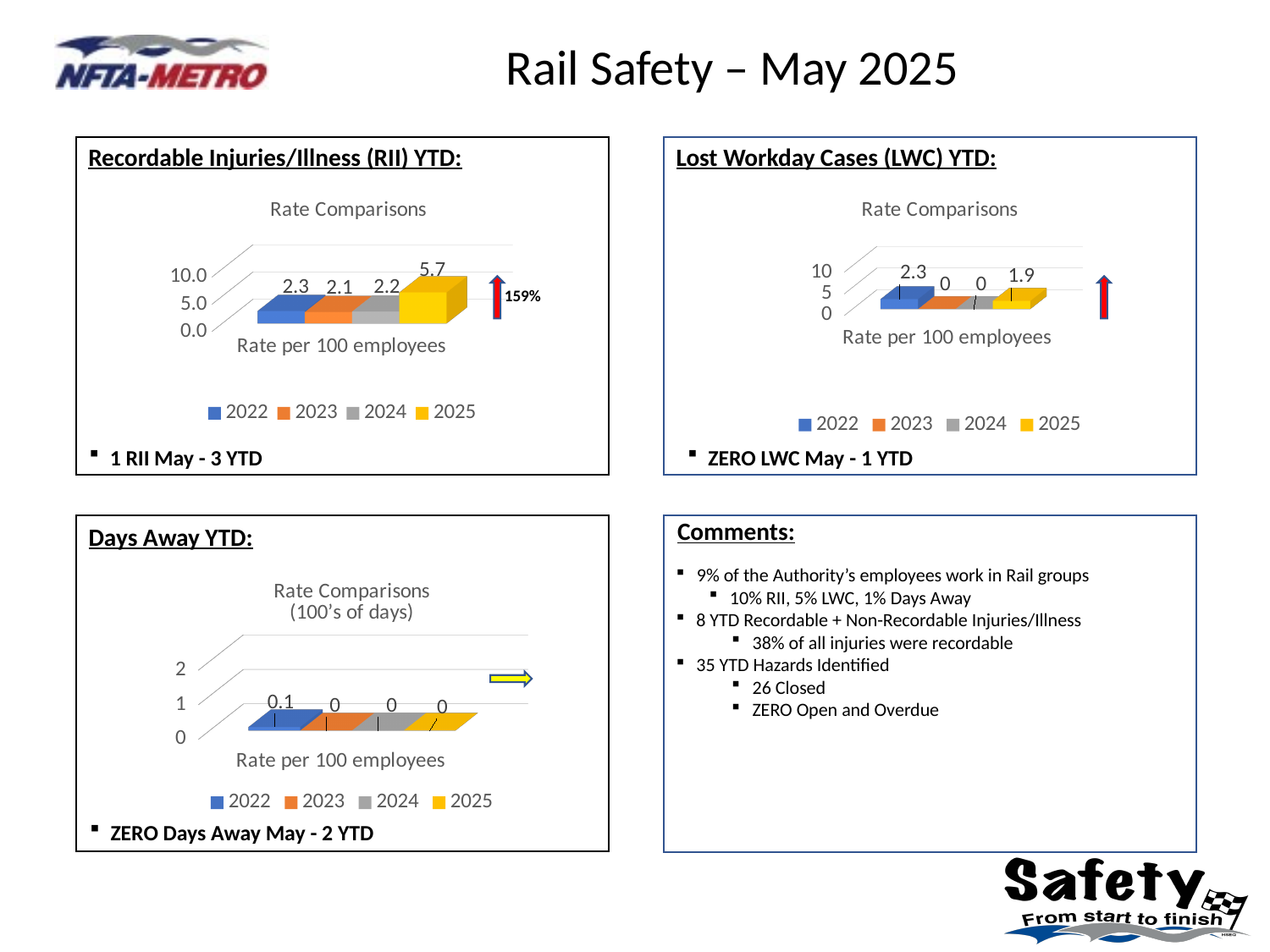
What kind of chart is the Days Away YTD chart? bar chart In the Recordable Injuries/Illness (RII) YTD chart, what is the value for 2025? 5.7 In the Lost Workday Cases (LWC) YTD chart, what is the difference between the 2022 and 2025 values? 0.4 In the Lost Workday Cases (LWC) YTD chart, which is larger, the value for 2022 or the value for 2025? 2022 In the Recordable Injuries/Illness (RII) YTD chart, which year has the highest rate? 2025 In the Lost Workday Cases (LWC) YTD chart, what is the value for 2022? 2.3 In the Days Away YTD chart, how many series does the legend list? 4 What is the title of the Recordable Injuries/Illness (RII) YTD chart? Rate Comparisons In the Recordable Injuries/Illness (RII) YTD chart, is the value for 2025 greater or less than 5.0? greater In the Recordable Injuries/Illness (RII) YTD chart, what is the difference between the 2025 and 2022 values? 3.4 In the Days Away YTD chart, what is the value for 2022? 0.1 In the Recordable Injuries/Illness (RII) YTD chart, which year has the lowest rate? 2023